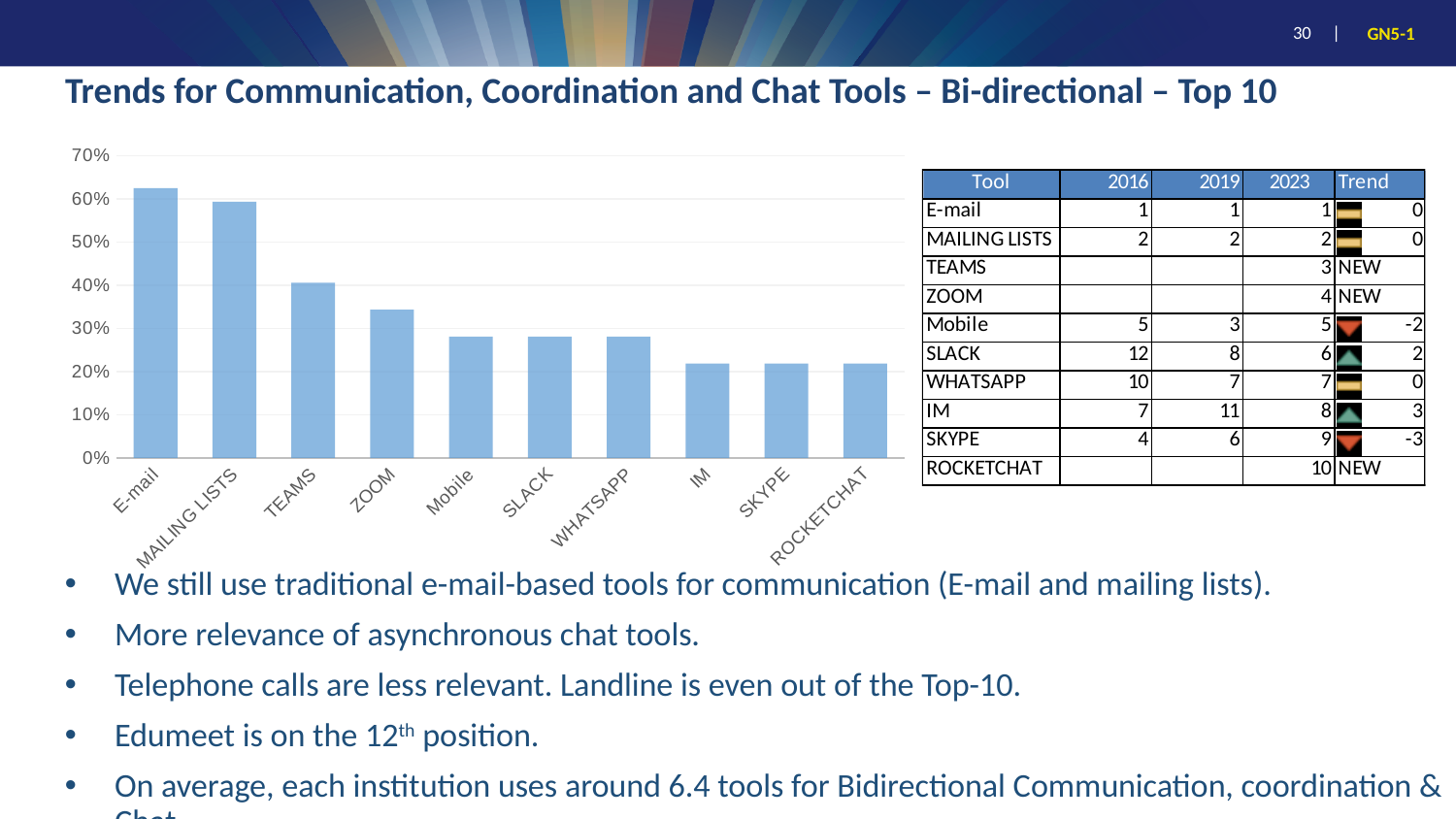
Is the value for SKYPE greater or less than 30%? less Is the value for TEAMS greater or less than 50%? less Is the value for ZOOM greater or less than 30%? greater Which has a higher value, E-mail or SLACK? E-mail How many tools (categories) are plotted in the bar chart? 10 Which has a higher value, TEAMS or ZOOM? TEAMS Do the bar values generally rise or fall from left to right along the x axis? fall What is the title of the slide containing the chart? Trends for Communication, Coordination and Chat Tools – Bi-directional – Top 10 Which tool has the highest bar in the chart? E-mail What kind of chart is shown on the slide? bar chart